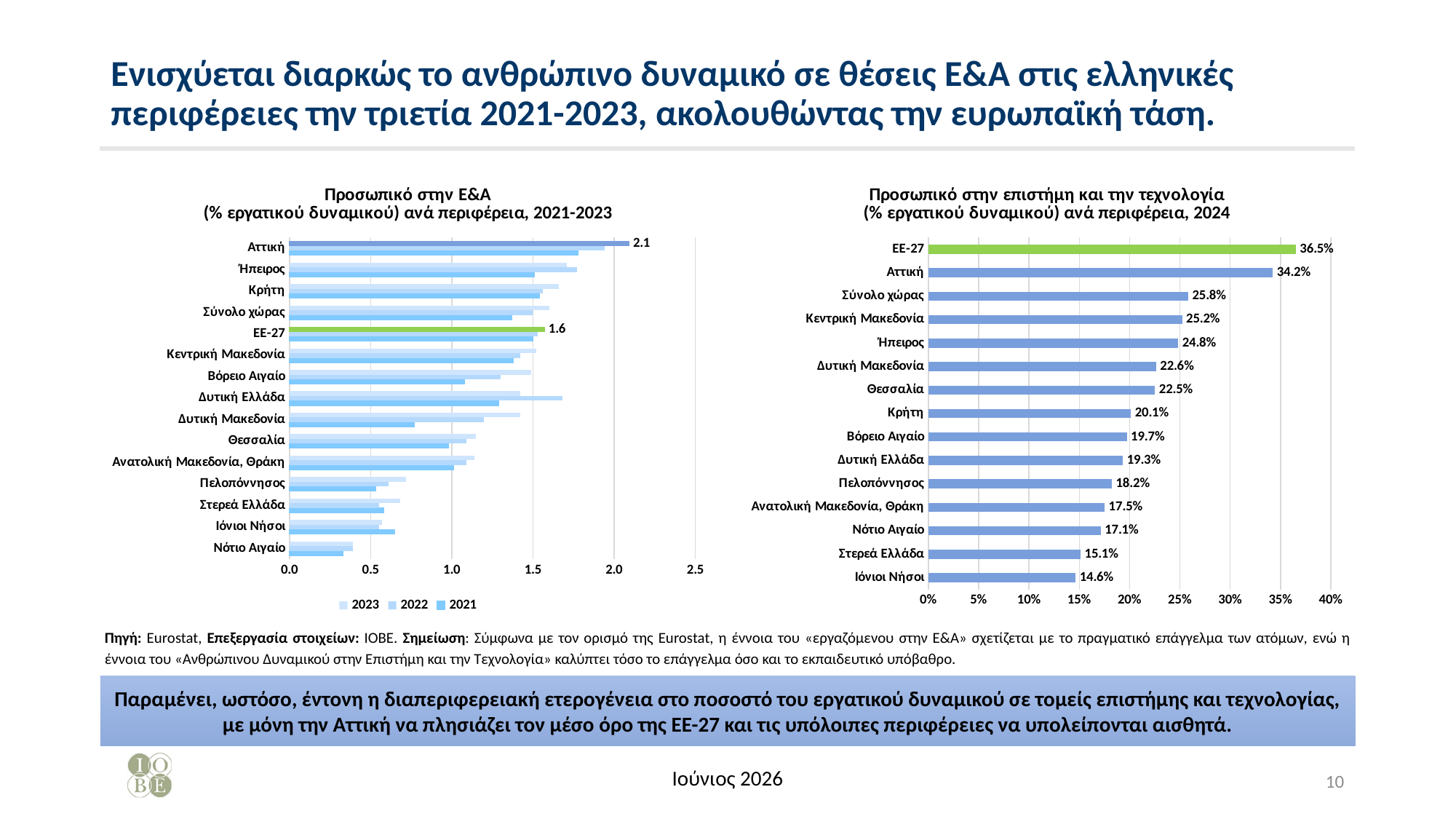
In the right chart (Προσωπικό στην επιστήμη και την τεχνολογία, 2024), which category has the lowest value? Ιόνιοι Νήσοι How many series does the legend of the left chart (Προσωπικό στην Ε&Α, 2021-2023) list? 3 In the right chart (Προσωπικό στην επιστήμη και την τεχνολογία, 2024), what is the value for Κρήτη? 20.1% In the right chart (Προσωπικό στην επιστήμη και την τεχνολογία, 2024), what is the difference between ΕΕ-27 and Σύνολο χώρας? 10.7 percentage points In the right chart (Προσωπικό στην επιστήμη και την τεχνολογία, 2024), which is larger, Θεσσαλία or Πελοπόννησος? Θεσσαλία In the right chart (Προσωπικό στην επιστήμη και την τεχνολογία, 2024), which category has the highest value? ΕΕ-27 In the right chart (Προσωπικό στην επιστήμη και την τεχνολογία, 2024), what is the value for Αττική? 34.2% What kind of chart is the left chart (Προσωπικό στην Ε&Α, 2021-2023)? Bar chart How many categories are shown in the right chart (Προσωπικό στην επιστήμη και την τεχνολογία, 2024)? 15 In the left chart (Προσωπικό στην Ε&Α, 2021-2023), is the 2023 value for Νότιο Αιγαίο greater or less than 0.5? less In the left chart (Προσωπικό στην Ε&Α, 2021-2023), what is the labelled 2023 value for Αττική? 2.1 In the left chart (Προσωπικό στην Ε&Α, 2021-2023), what is the labelled 2023 value for ΕΕ-27? 1.6